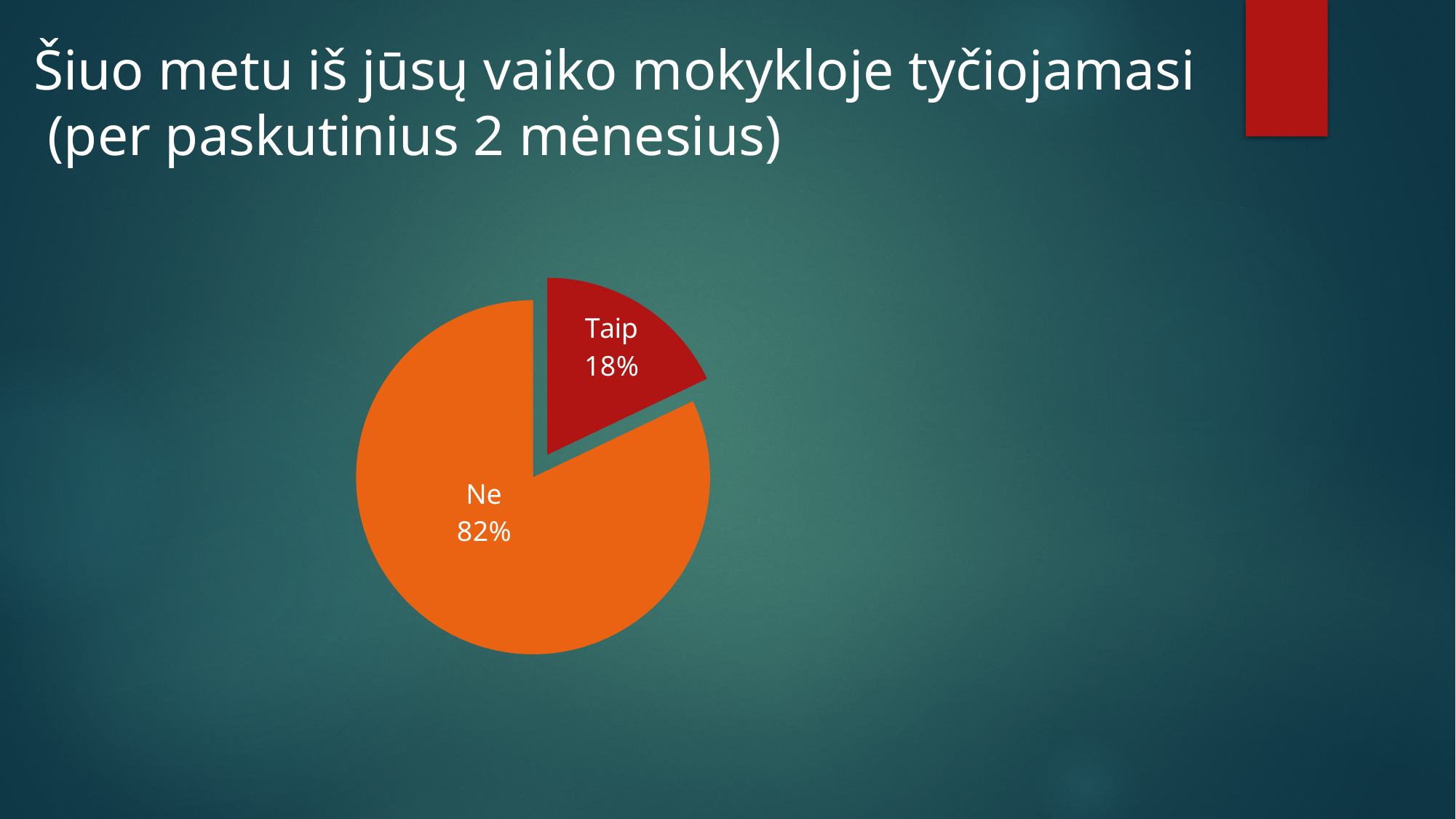
What colour is the "Taip" slice? red Which slice of the pie is the smallest? Taip Which slice of the pie is the largest? Ne What share of the pie does the "Ne" slice represent? 82% What kind of chart is shown on the slide? pie chart Which is larger, the "Taip" slice or the "Ne" slice? Ne What colour is the "Ne" slice? orange How many slices does the pie chart have? 2 What share of the pie does the "Taip" slice represent? 18% What is the difference in percentage points between the "Ne" and "Taip" slices? 64